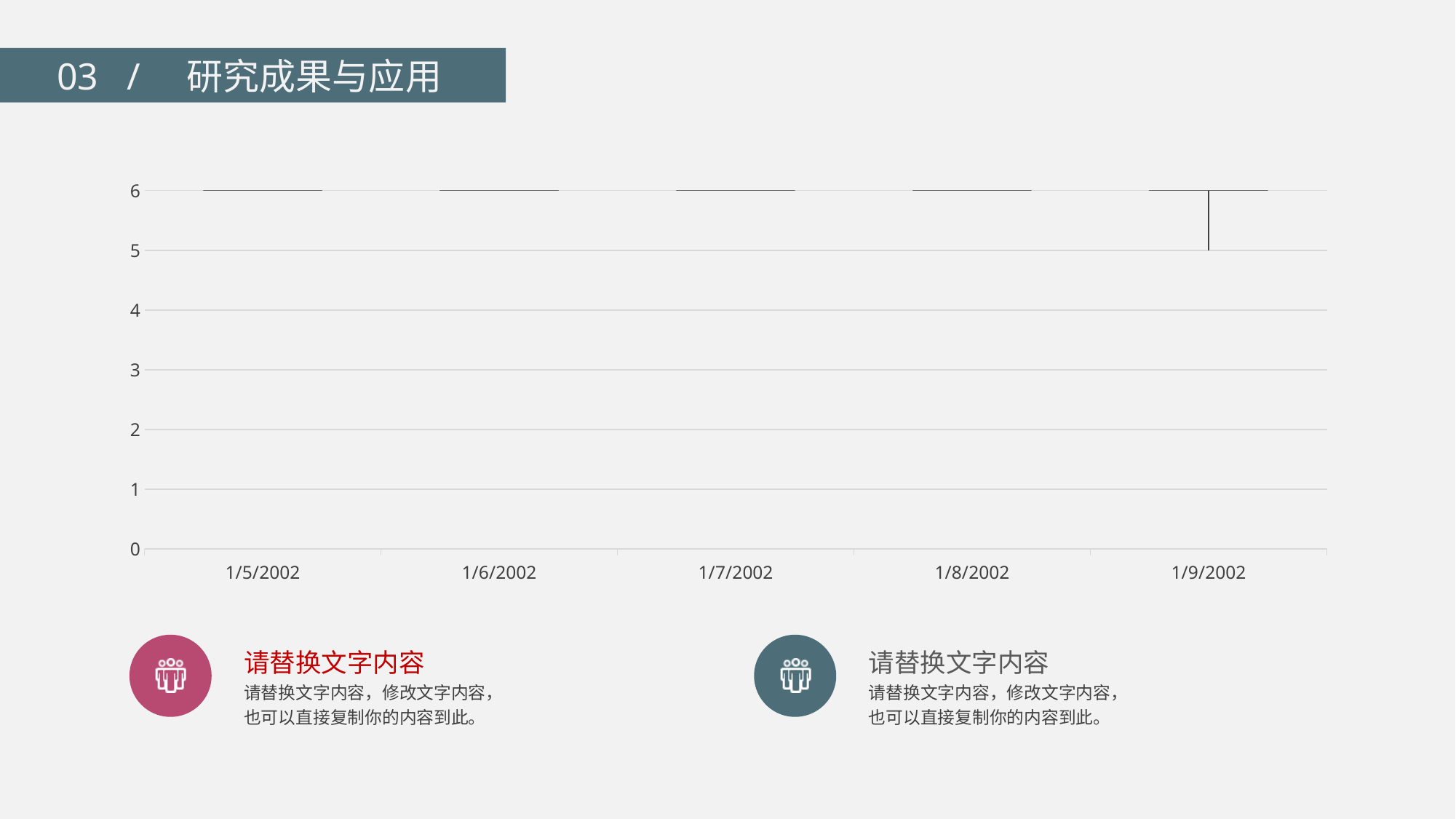
What value does the horizontal line for 1/7/2002 sit on? 6 What is the last date shown on the x axis of the chart? 1/9/2002 Is the value for 1/6/2002 greater or less than 3? greater What value does the horizontal line for 1/5/2002 sit on? 6 What is the lowest value reached by the vertical line at 1/9/2002? 5 What kind of chart is shown on the slide? stock chart What is the first date shown on the x axis of the chart? 1/5/2002 How many dates are shown on the x axis of the chart? 5 Is the low value at 1/9/2002 greater or less than 4? greater What is the highest value shown on the y axis of the chart? 6 Which date is the only one with a vertical line extending below 6? 1/9/2002